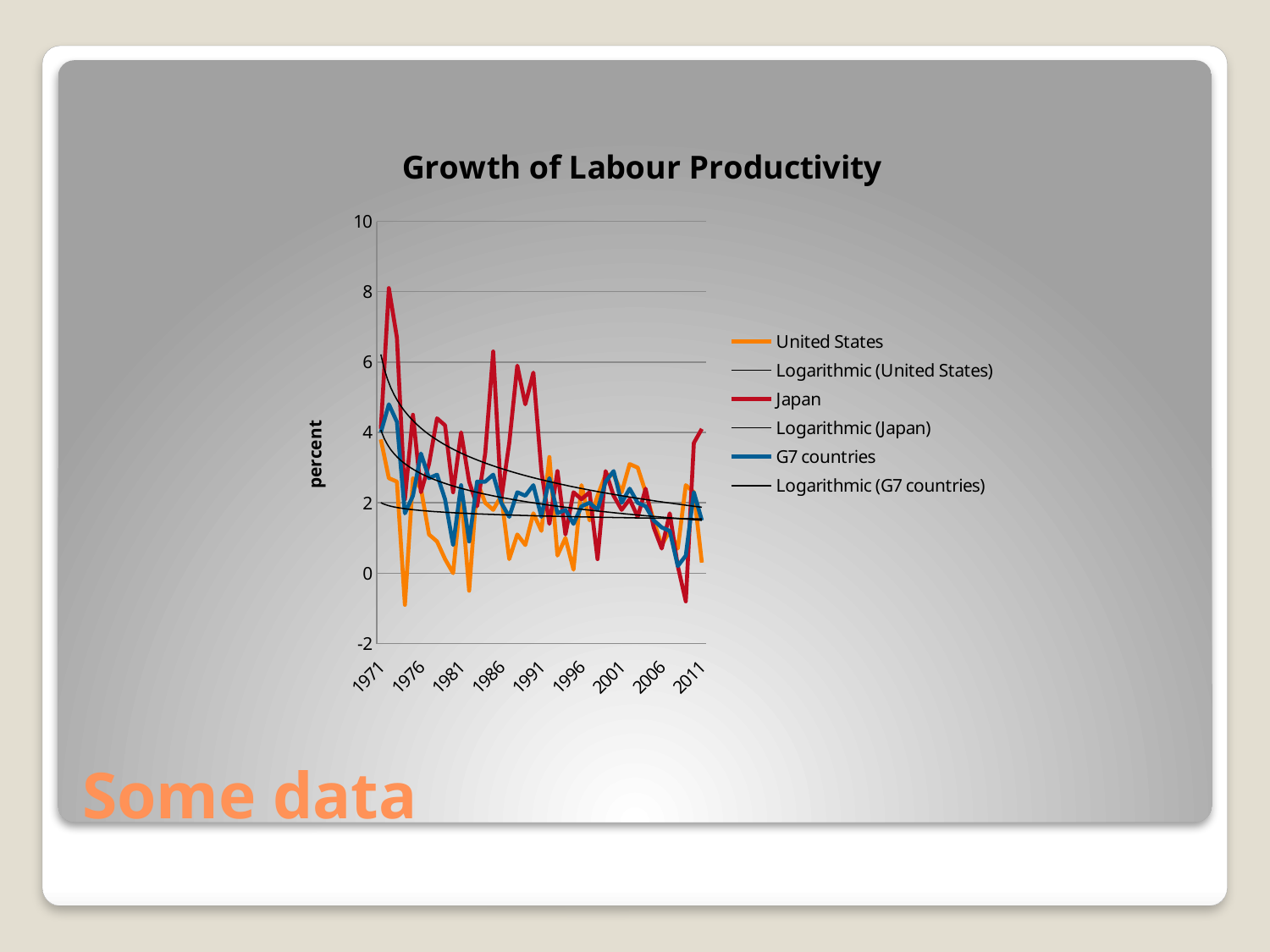
What kind of chart is shown on the slide? line chart Is the peak value for Japan in the early 1970s greater or less than 6? greater What is the title of the chart? Growth of Labour Productivity Is the lowest value for United States in the mid-1970s greater or less than 0? less How many year labels are shown on the x axis? 9 Around 1973, which is higher, Japan or United States? Japan How many entries does the legend list? 6 Is the value for Japan in 2011 greater or less than 2? greater Does the Logarithmic (Japan) trendline rise or fall from 1971 to 2011? fall What is the label on the vertical axis? percent Which series reaches the highest value anywhere on the chart? Japan